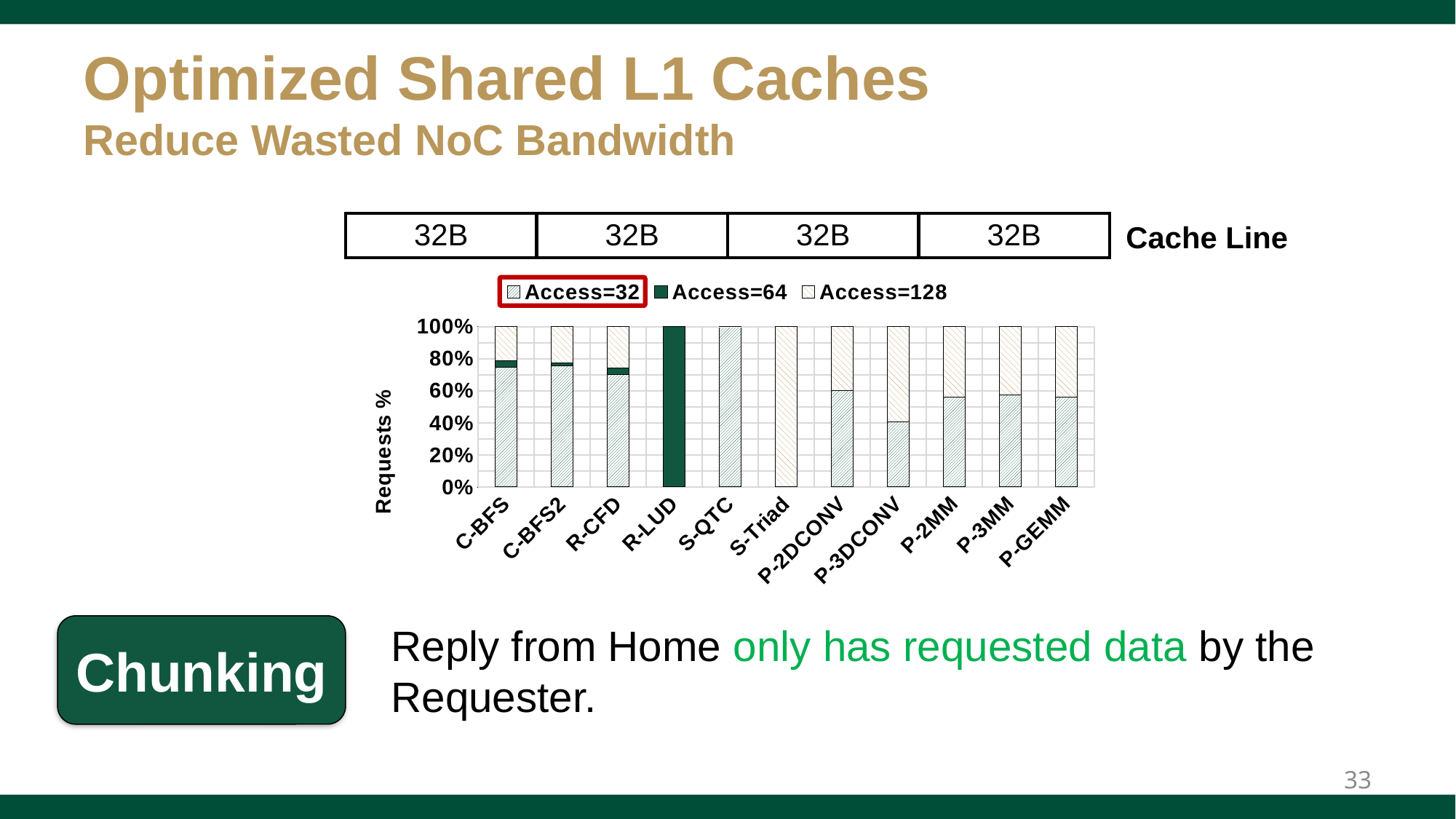
How many series does the chart's legend list? 3 What kind of chart is shown on the slide? stacked bar chart Which legend entry is highlighted with a red box? Access=32 Which benchmark has the highest Access=128 share of requests? S-Triad How many benchmark categories are shown on the x axis of the chart? 11 What are the three series listed in the chart's legend? Access=32, Access=64, Access=128 What is the Access=64 share of requests for R-LUD? 100% Which benchmark has the highest Access=64 share of requests? R-LUD Is the Access=32 share for C-BFS greater or less than 60%? greater Which has a larger Access=32 share of requests, C-BFS or P-3DCONV? C-BFS Is the Access=32 share for P-3DCONV greater or less than 60%? less